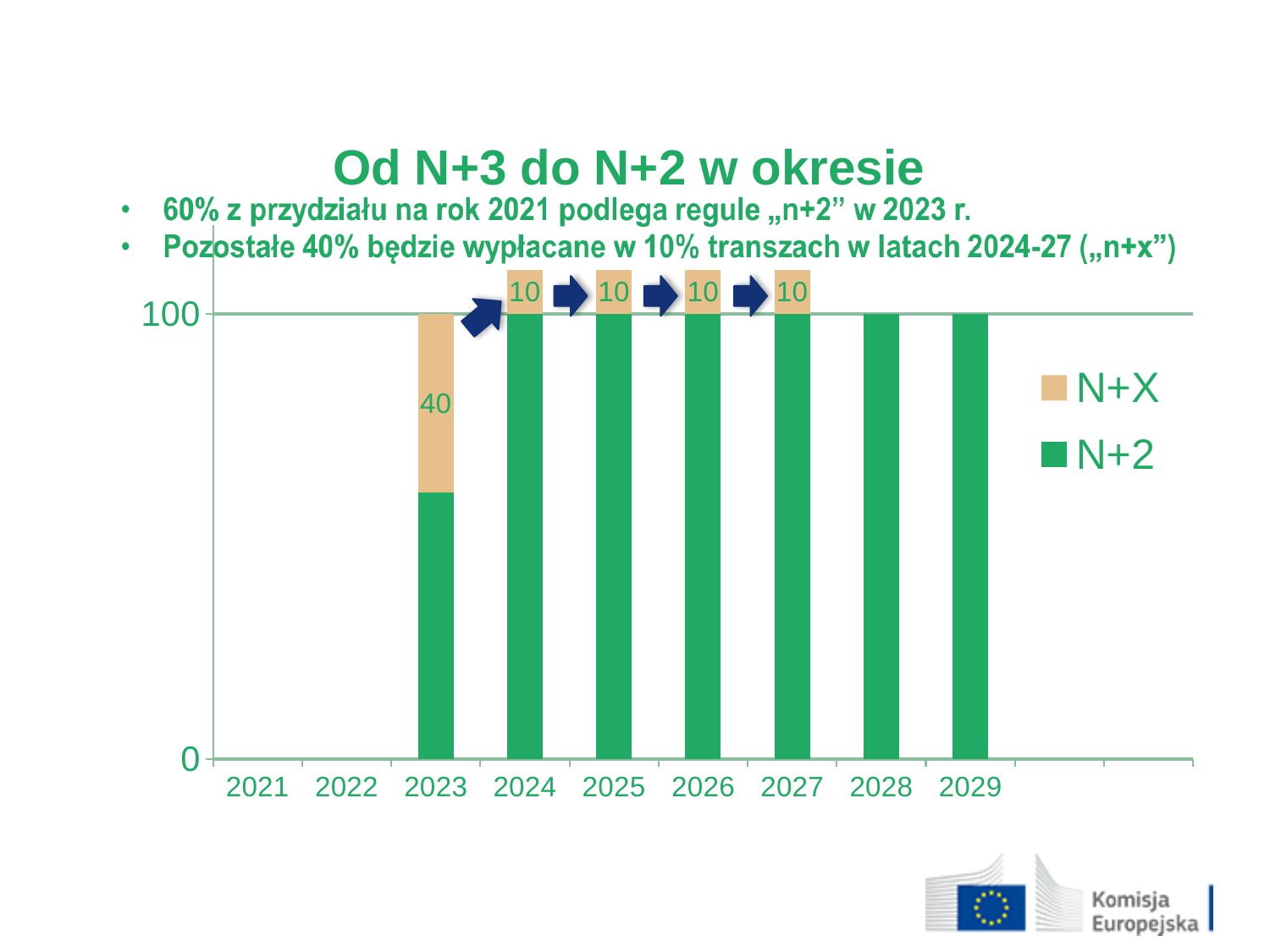
What is the difference between the N+X value for 2023 and the N+X value for 2026? 30 What is the N+X value for 2025? 10 How many series does the legend list? 2 What kind of chart is shown on the slide? stacked bar chart How many years are labelled on the x axis? 9 What is the N+2 value for 2028? 100 Is the N+2 value for 2023 greater or less than 100? less Does the N+X value rise, fall or stay the same from 2024 to 2027? stays the same Which is larger, the N+X value for 2023 or for 2024? 2023 What are the two entries in the legend? N+X and N+2 What is the N+X value for 2023? 40 Which year has the highest N+X value? 2023